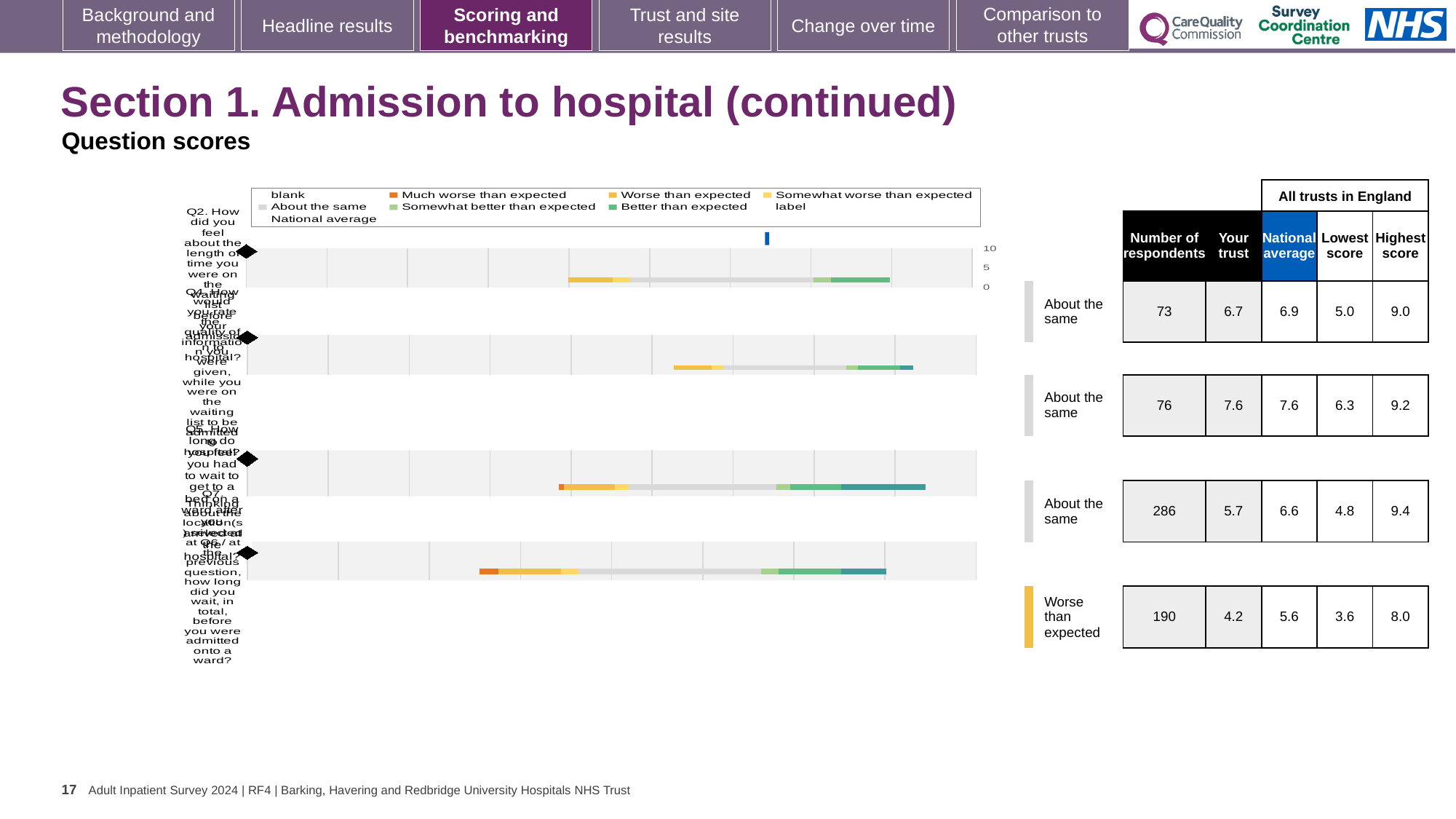
In the table beside the chart, is the 'Your trust' score for the row with 76 respondents larger or smaller than the national average for that row? equal (both 7.6) What kind of chart is shown on the slide? bar chart In the table beside the chart, what is the national average for the row with 286 respondents? 6.6 In the table beside the chart, which row has the lowest 'Your trust' score? Worse than expected (190 respondents) In the table beside the chart, what is the difference between the national average and 'Your trust' score for the row with 190 respondents? 1.4 What is the highest value shown on the chart's axis? 10 In the table beside the chart, what is the 'Your trust' score for the first row (About the same, 73 respondents)? 6.7 In the table beside the chart, which row has the most respondents? the third row (286 respondents) Which legend entry is shown in orange in the chart's legend? Much worse than expected In the table beside the chart, what is the highest score for the row with 76 respondents? 9.2 How many horizontal bars (question rows) are plotted in the chart? 4